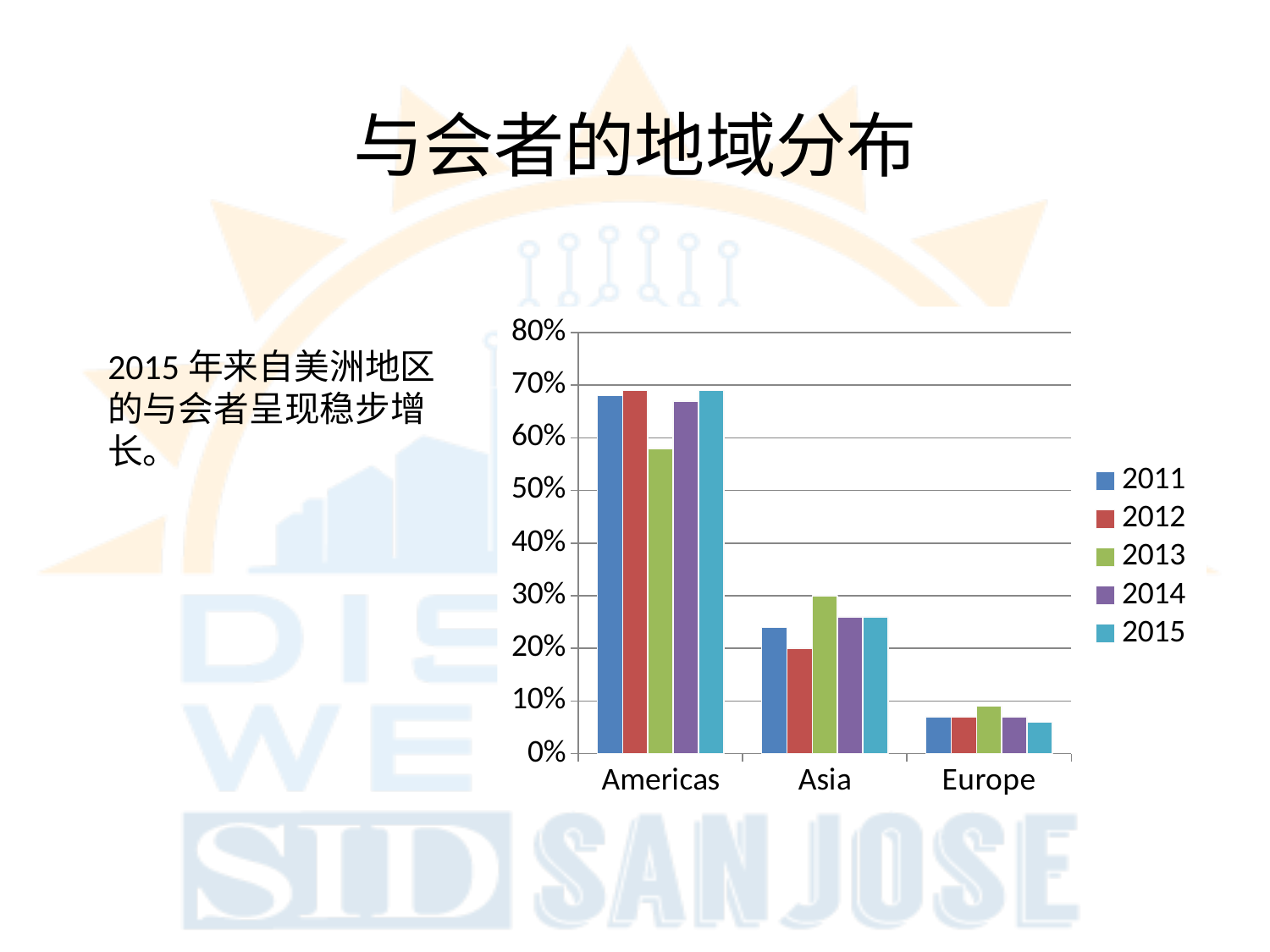
Which years are listed in the chart's legend? 2011, 2012, 2013, 2014, 2015 Which is larger for Asia: the 2012 value or the 2013 value? 2013 How many regions are shown on the x axis of the chart? 3 Which region has the lowest values in the chart? Europe How many series does the chart's legend list? 5 What kind of chart is shown on the slide? bar chart For Asia, which year has the highest bar? 2013 For Americas, which year has the lowest bar? 2013 Is the value for Asia in 2012 greater or less than 30%? less Is the value for Asia in 2013 greater or less than 20%? greater Which region has the highest values in the chart? Americas Is the value for Americas in 2013 greater or less than 60%? less